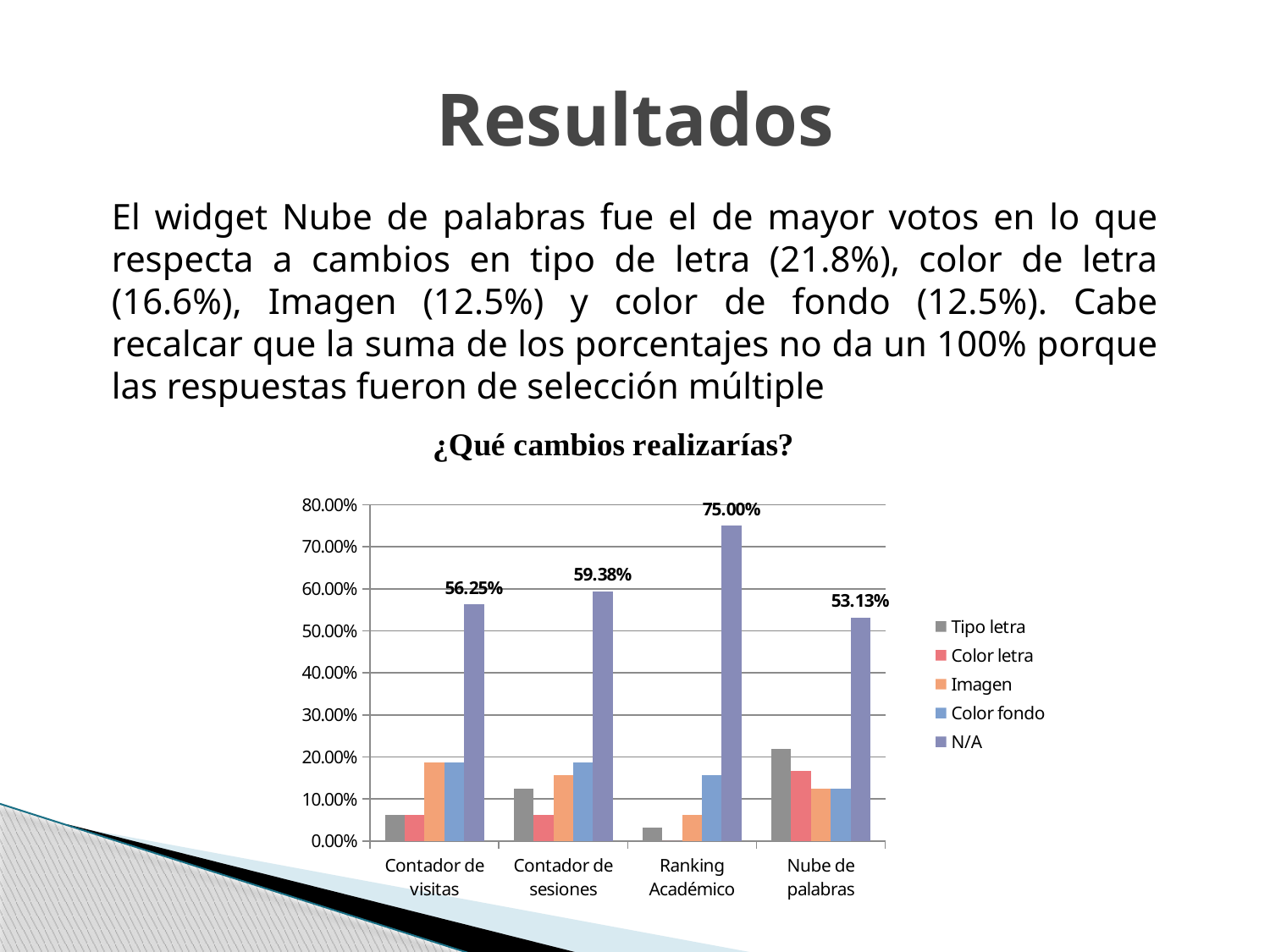
How many categories are shown on the x axis? 4 Which is larger, the N/A value for Contador de sesiones or for Contador de visitas? Contador de sesiones How many series does the legend list? 5 What is the N/A value for Nube de palabras? 53.13% Is the Tipo letra value for Nube de palabras greater or less than 20.00%? greater What is the difference between the N/A values for Ranking Académico and Contador de sesiones? 15.62% What is the N/A value for Contador de visitas? 56.25% What kind of chart is shown on the slide? Bar chart Which category has the highest N/A value? Ranking Académico Is the Tipo letra value for Ranking Académico greater or less than 10.00%? less Which category has the lowest N/A value? Nube de palabras What is the N/A value for Ranking Académico? 75.00%